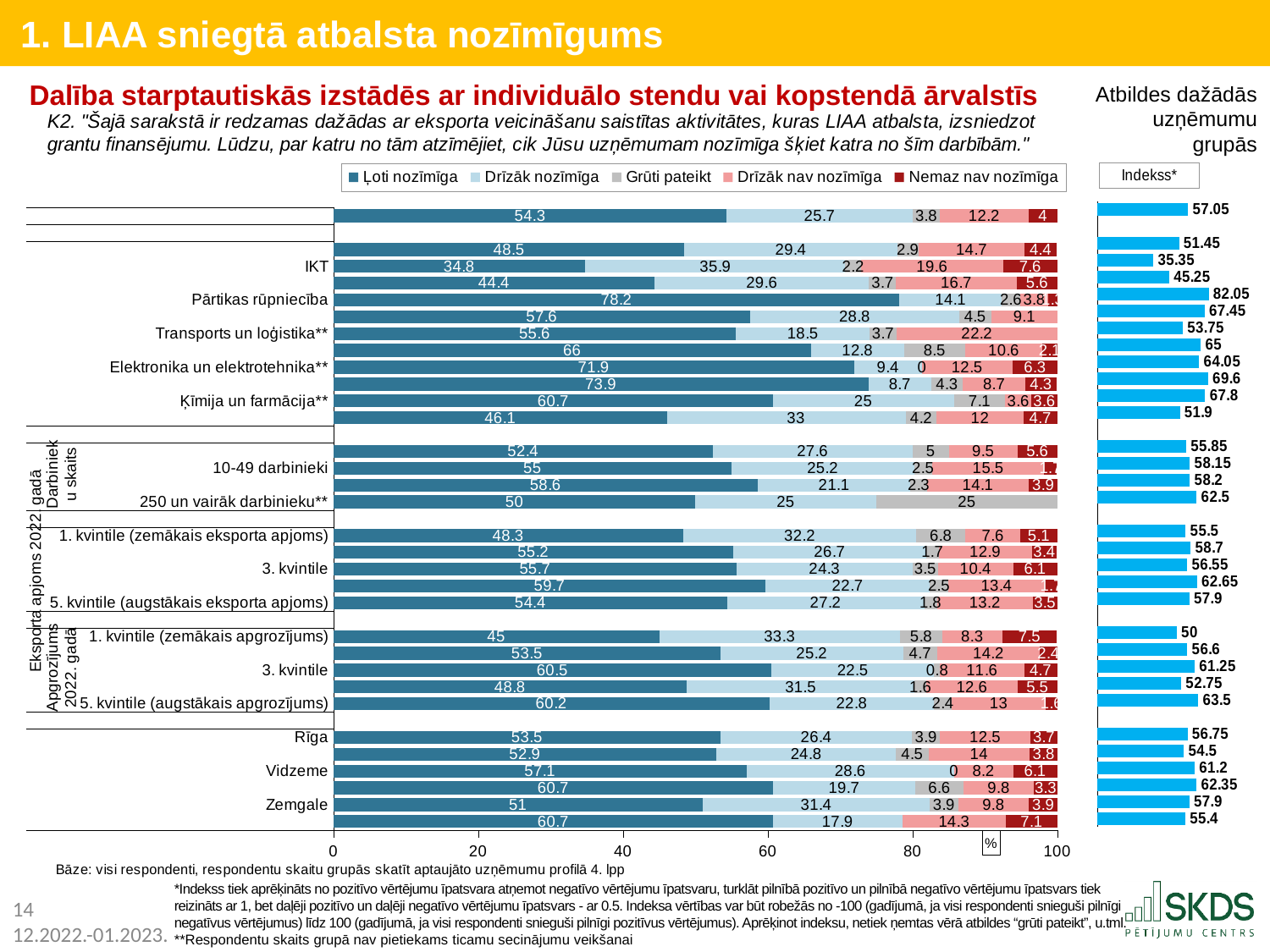
How many series does the legend of the main chart list? 5 In the main chart, which labelled category has the lowest 'Ļoti nozīmīga' value? IKT In the main chart, which has the larger 'Ļoti nozīmīga' value, Vidzeme or Zemgale? Vidzeme In the Indekss* chart on the right, what is the index value for Pārtikas rūpniecība? 82.05 In the main chart, which labelled category has the highest 'Ļoti nozīmīga' value? Pārtikas rūpniecība What kind of chart is the main chart on the slide? Stacked bar chart In the main chart, what is the 'Drīzāk nozīmīga' value for Ķīmija un farmācija**? 25 In the main chart, what is the 'Ļoti nozīmīga' value for Pārtikas rūpniecība? 78.2 In the Indekss* chart on the right, which labelled category has the lowest index value? IKT In the main chart, what is the 'Nemaz nav nozīmīga' value for Elektronika un elektrotehnika**? 6.3 In the main chart, what is the difference between the 'Ļoti nozīmīga' values for Rīga and Zemgale? 2.5 In the main chart, what is the 'Drīzāk nav nozīmīga' value for IKT? 19.6